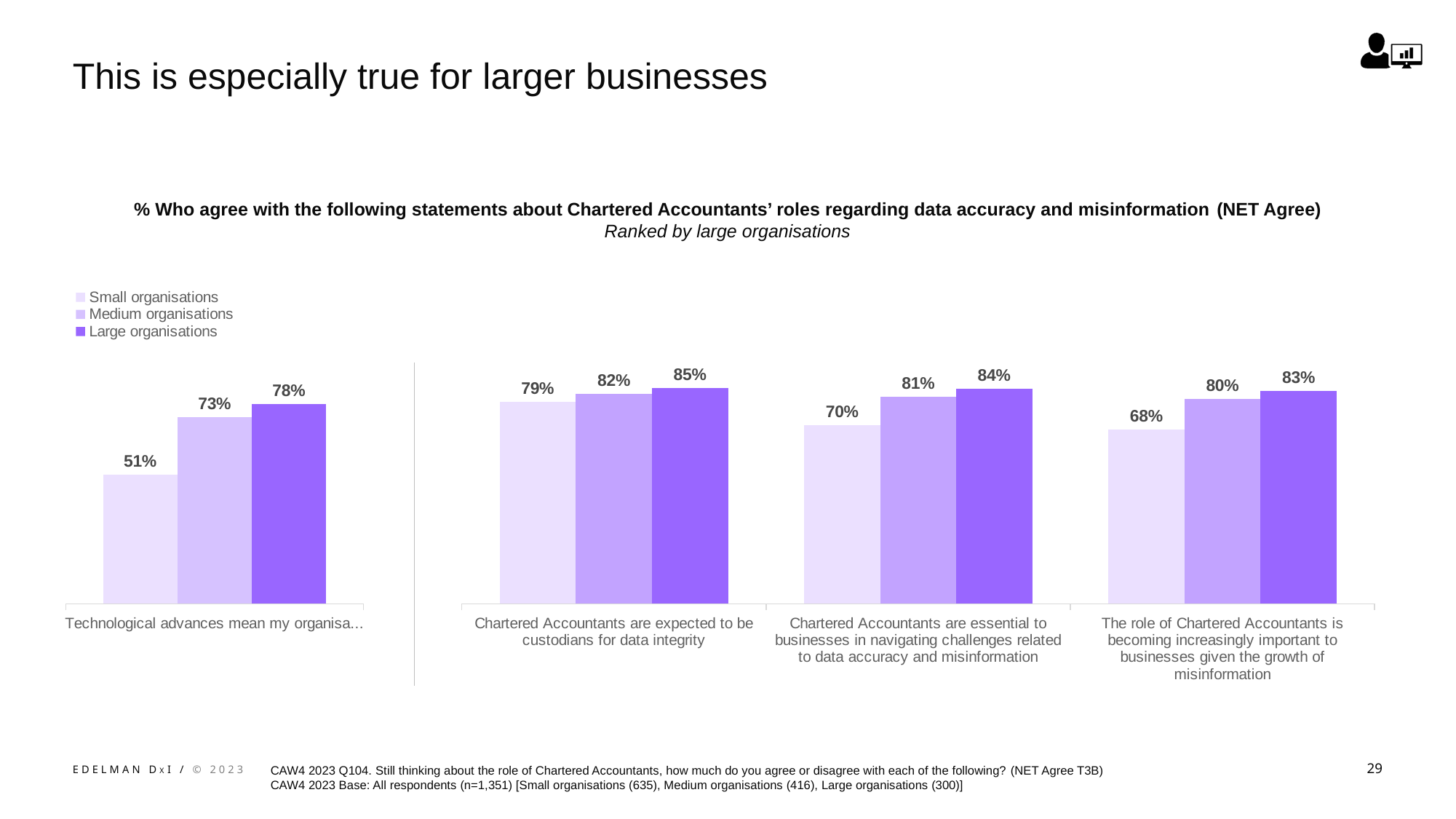
In the left-hand chart, what is the value for small organisations? 51% In the right-hand chart, what percentage of small organisations agree that the role of Chartered Accountants is becoming increasingly important to businesses given the growth of misinformation? 68% In the right-hand chart, what percentage of large organisations agree that Chartered Accountants are expected to be custodians for data integrity? 85% In the right-hand chart, which is larger for the statement 'Chartered Accountants are expected to be custodians for data integrity': the small organisations value or the medium organisations value? Medium organisations In the right-hand chart, what is the difference between large and small organisations for the statement 'Chartered Accountants are essential to businesses in navigating challenges related to data accuracy and misinformation'? 14 percentage points In the left-hand chart, what is the value for large organisations? 78% In the right-hand chart, which statement has the highest value for large organisations? Chartered Accountants are expected to be custodians for data integrity How many series does the legend list? 3 In the right-hand chart, which statement has the lowest value for small organisations? The role of Chartered Accountants is becoming increasingly important to businesses given the growth of misinformation In the left-hand chart, what is the difference between the large organisations value and the small organisations value? 27 percentage points What type of chart is used on this slide? Bar chart In the right-hand chart, what is the value for medium organisations for the statement 'Chartered Accountants are essential to businesses in navigating challenges related to data accuracy and misinformation'? 81%